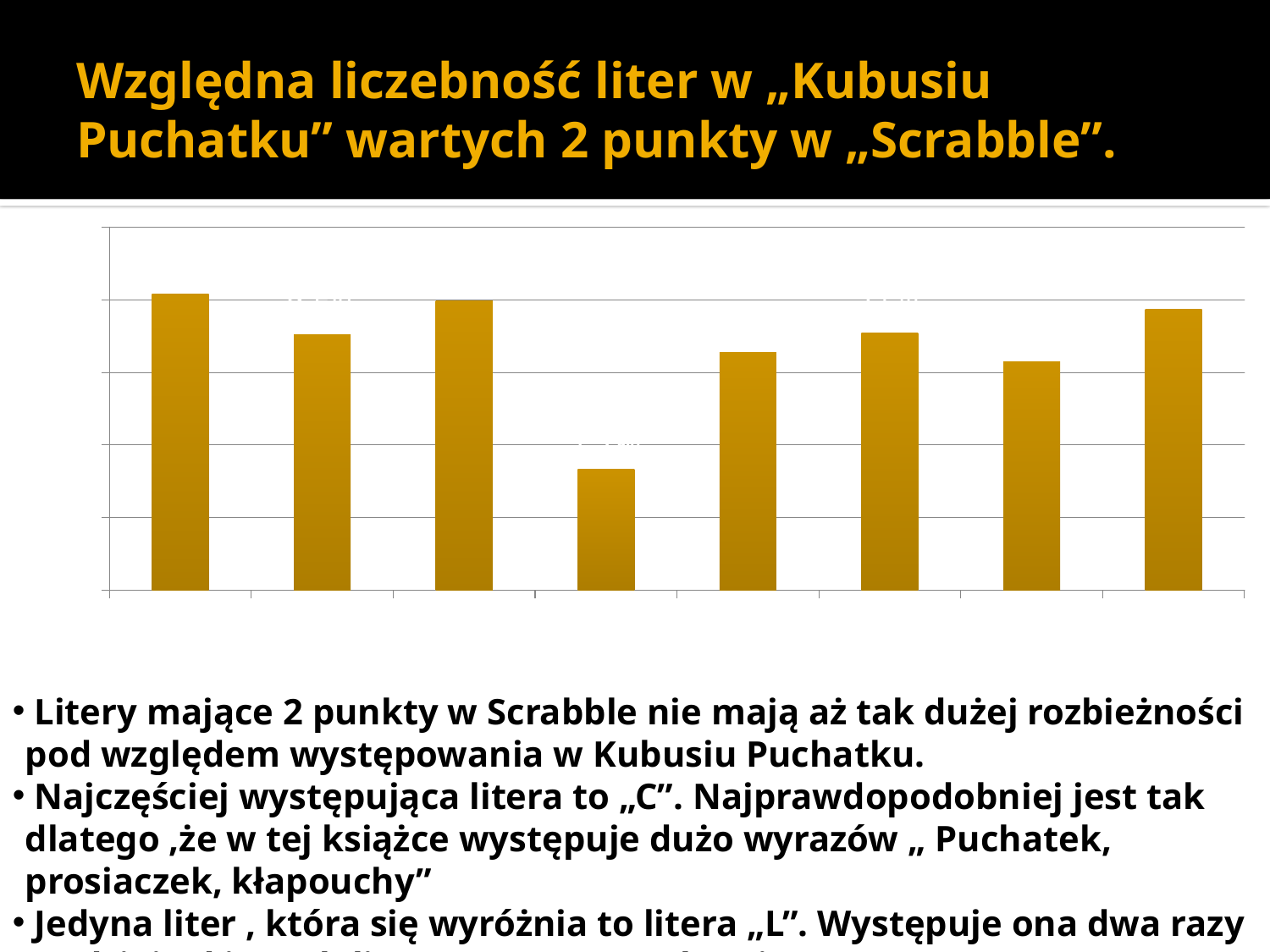
Is the last bar on the right taller or shorter than the bar immediately to its left? taller What kind of chart is shown on the slide? bar chart How many bars are plotted in the chart? 8 Counting from the left, which bar in the chart is the lowest? the fourth bar What colour are the bars in the chart? gold Is the first bar from the left taller or shorter than the second bar from the left? taller Is the fourth bar from the left taller or shorter than the fifth bar from the left? shorter Does the chart have a legend? No